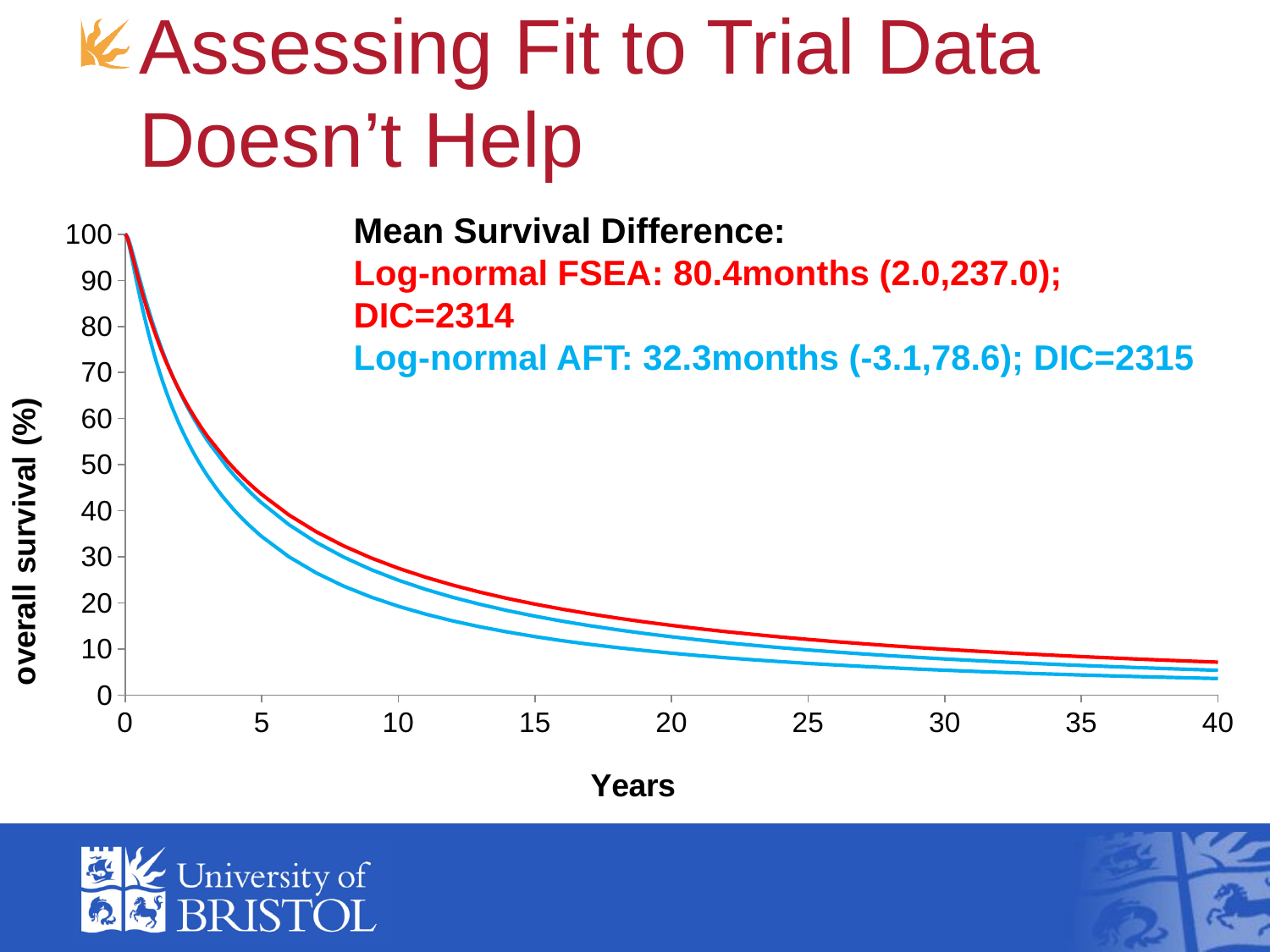
What is the label of the y axis? overall survival (%) Is the value of the red curve at 40 years greater or less than 10? less Is the value of the lowest blue curve at 40 years greater or less than 10? less Is the value of the red curve at 20 years greater or less than 20? less What is the label of the x axis? Years What is the overall survival (%) at 0 years for the curves? 100 How many curves are plotted on the chart? 3 What kind of chart is shown on the slide? line chart Do the survival curves rise or fall as years increase? fall At 20 years, which curve is higher: the red curve or the lowest blue curve? the red curve What is the highest tick value shown on the x axis? 40